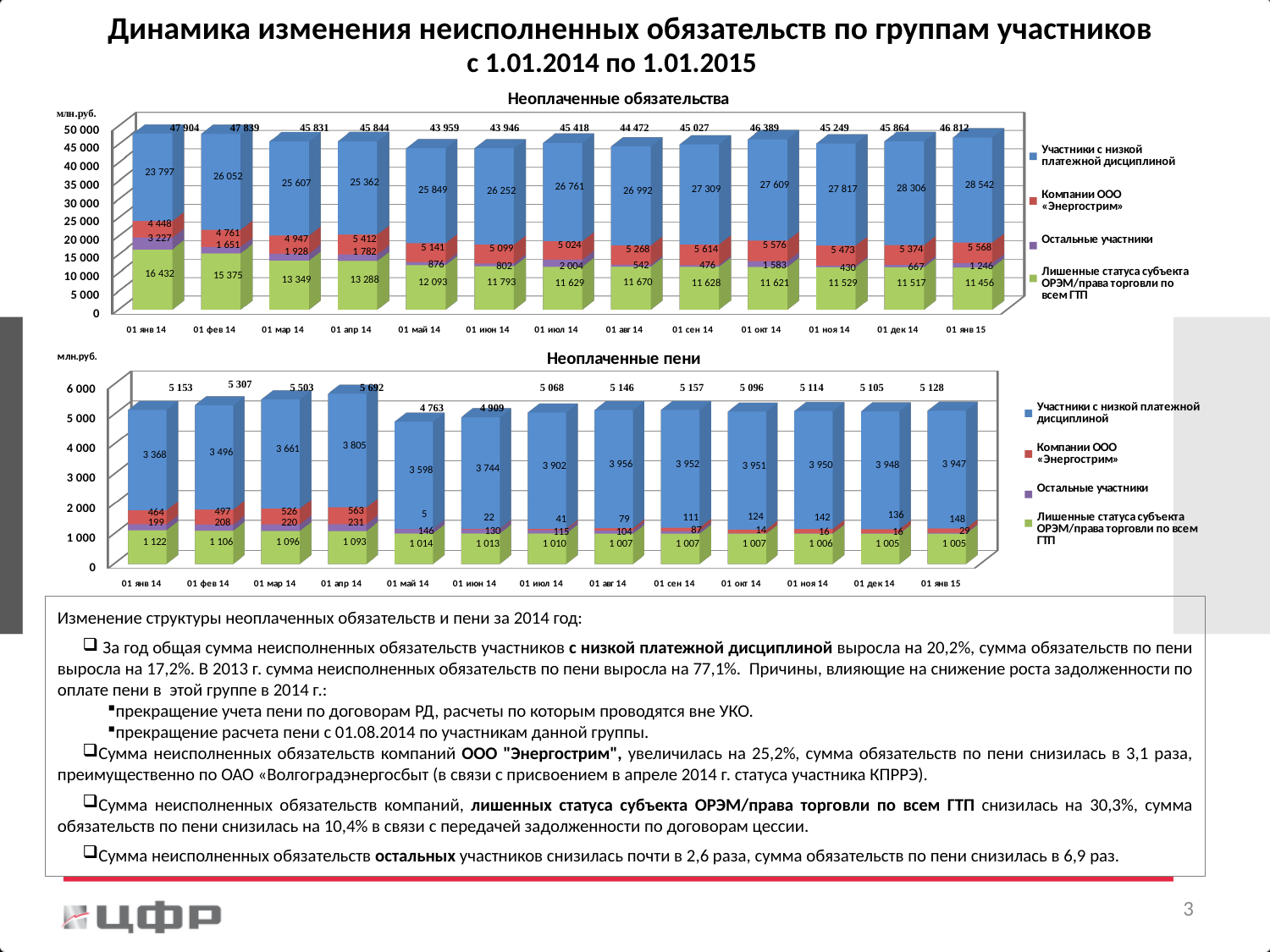
In the 'Неоплаченные пени' chart, what is the value for 'Компании ООО «Энергострим»' on 01 май 14? 5 How many series does the legend of the 'Неоплаченные обязательства' chart list? 4 In the 'Неоплаченные обязательства' chart, what is the value for 'Участники с низкой платежной дисциплиной' on 01 янв 15? 28 542 In the 'Неоплаченные пени' chart, what is the difference between the 'Остальные участники' values on 01 янв 14 and 01 янв 15? 170 What type of chart is the 'Неоплаченные пени' chart? Stacked bar chart In the 'Неоплаченные пени' chart, what is the total of the stacked bar for 01 янв 15? 5 128 How many dates (categories) are shown on the x axis of the 'Неоплаченные пени' chart? 13 In the 'Неоплаченные обязательства' chart, is the value for 'Компании ООО «Энергострим»' on 01 сен 14 larger or smaller than on 01 янв 14? larger In the 'Неоплаченные обязательства' chart, which date has the lowest total unpaid obligations? 01 июн 14 In the 'Неоплаченные обязательства' chart, what is the total of the stacked bar for 01 янв 14? 47 904 In the 'Неоплаченные пени' chart, which date has the highest total unpaid penalties? 01 апр 14 In the 'Неоплаченные обязательства' chart, what is the difference between the 'Лишенные статуса субъекта ОРЭМ/права торговли по всем ГТП' values on 01 янв 14 and 01 янв 15? 4 976